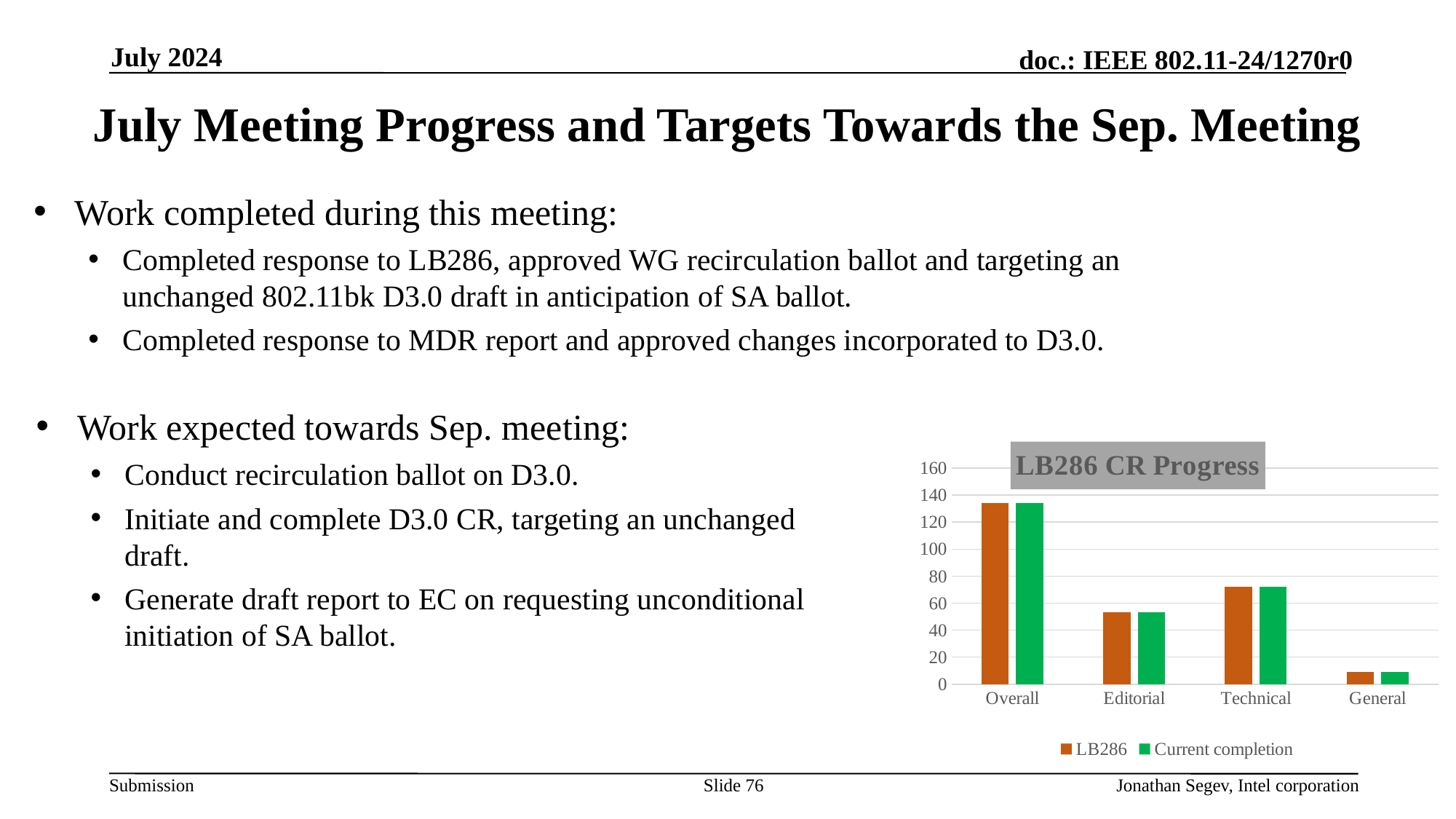
Is the LB286 value for Technical greater or less than 60? greater Which category has the lowest Current completion value? General Which series is shown in green in the chart? Current completion Is the Current completion value for Editorial greater or less than 60? less Which category has the highest LB286 value? Overall Is the LB286 value for Overall greater or less than 120? greater Which is larger, the LB286 value for Technical or the LB286 value for Editorial? Technical What kind of chart is shown on the slide? bar chart What is the title of the chart? LB286 CR Progress How many series does the chart legend list? 2 How many categories are shown on the x axis of the chart? 4